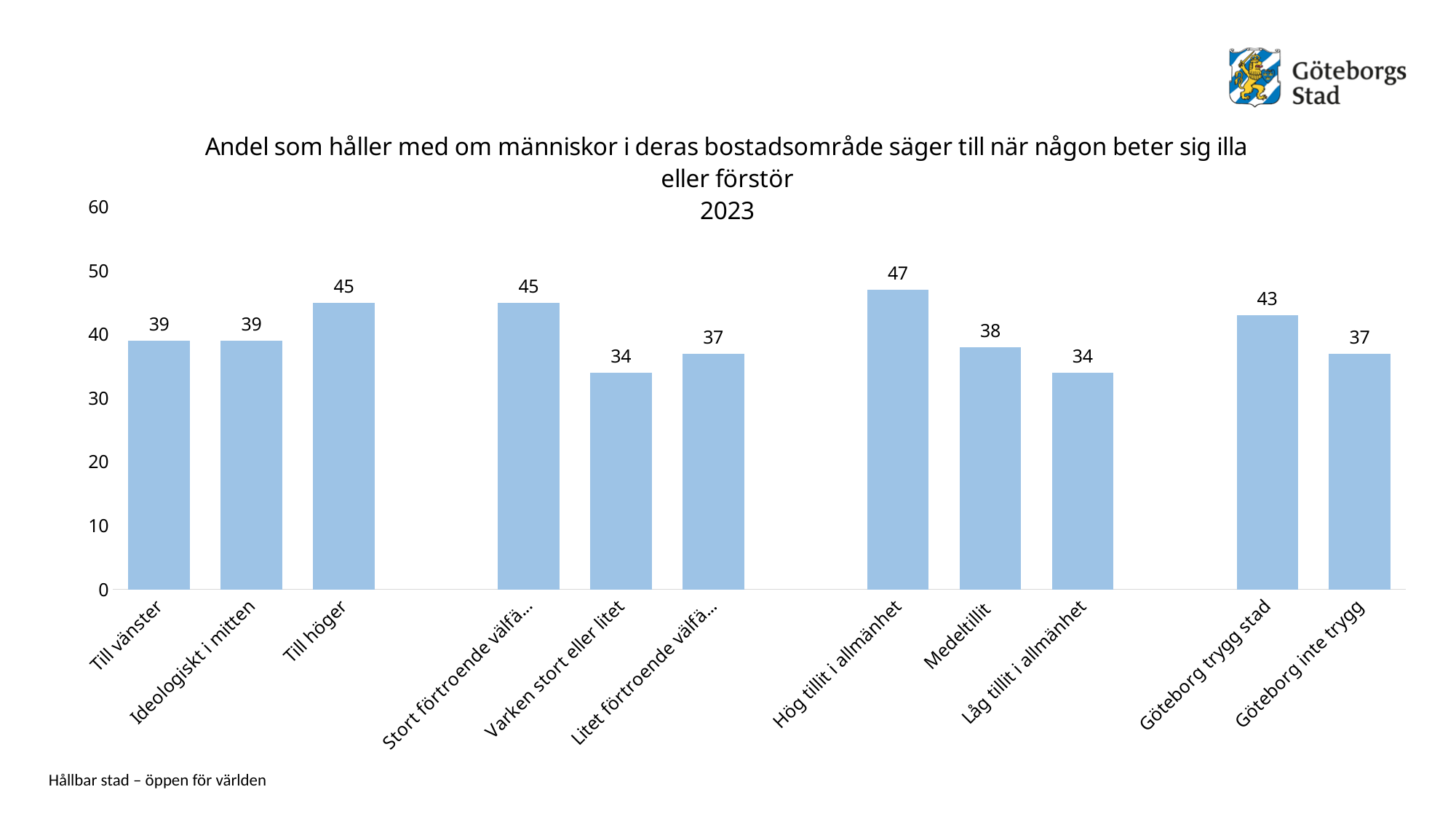
What is the value for Hög tillit i allmänhet? 47 What is the value for Medeltillit? 38 What is the difference between the values for Göteborg trygg stad and Göteborg inte trygg? 6 Which category has the highest value? Hög tillit i allmänhet What is the value for Till höger? 45 What kind of chart is shown on the slide? Bar chart Is the value for Låg tillit i allmänhet greater or less than 40? less What is the lowest value shown in the chart? 34 What year is shown in the chart title? 2023 What is the value for Göteborg trygg stad? 43 Which is larger, the value for Till höger or the value for Till vänster? Till höger How many bars are shown in the chart? 11